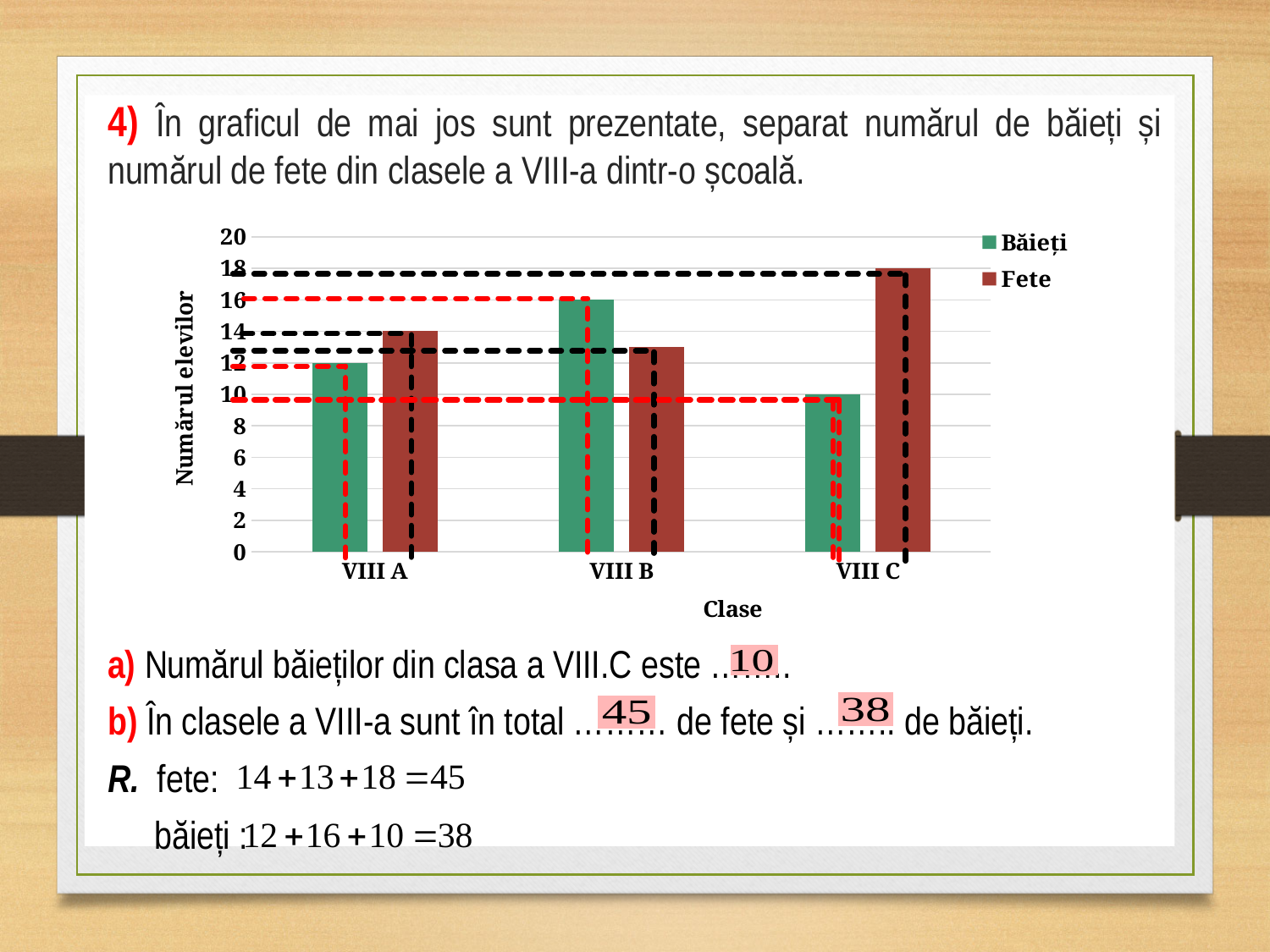
In class VIII B, which is larger: the number of Băieți or the number of Fete? Băieți What is the number of Băieți in class VIII B? 16 How many series does the legend list? 2 What is the number of Băieți in class VIII C? 10 How many classes (categories) are shown on the x axis? 3 Which class has the highest number of Fete? VIII C What is the number of Fete in class VIII A? 14 What is the number of Fete in class VIII C? 18 Which class has the lowest number of Băieți? VIII C What kind of chart is shown on the slide? bar chart What is the difference between the number of Fete and the number of Băieți in class VIII C? 8 What is the total number of Fete across the three classes? 45